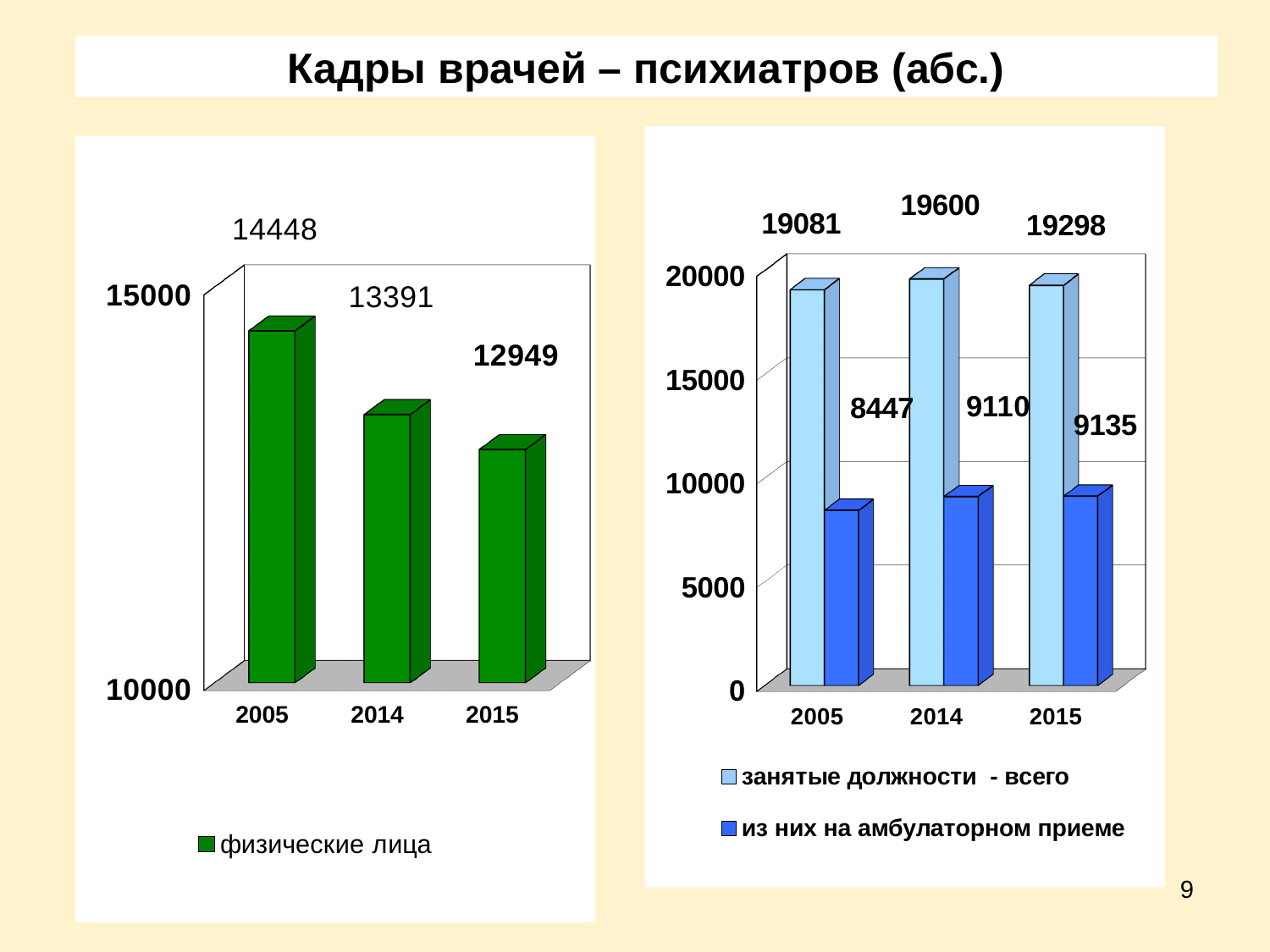
In the left chart, what is the value for физические лица in 2005? 14448 In the left chart, what is the difference between the 2005 and 2014 values? 1057 In the left chart, do the values rise or fall from 2005 to 2015? fall What kind of chart is the left chart? bar chart In the right chart, what is the difference between занятые должности - всего and из них на амбулаторном приеме in 2015? 10163 In the right chart, which year has the highest value for занятые должности - всего? 2014 In the right chart, what is the value for занятые должности - всего in 2014? 19600 In the left chart, which year has the lowest value? 2015 In the right chart, is the value for из них на амбулаторном приеме in 2014 greater or less than 10000? less In the right chart, what is the value for из них на амбулаторном приеме in 2005? 8447 In the left chart, what is the value for физические лица in 2015? 12949 In the right chart, how many series does the legend list? 2